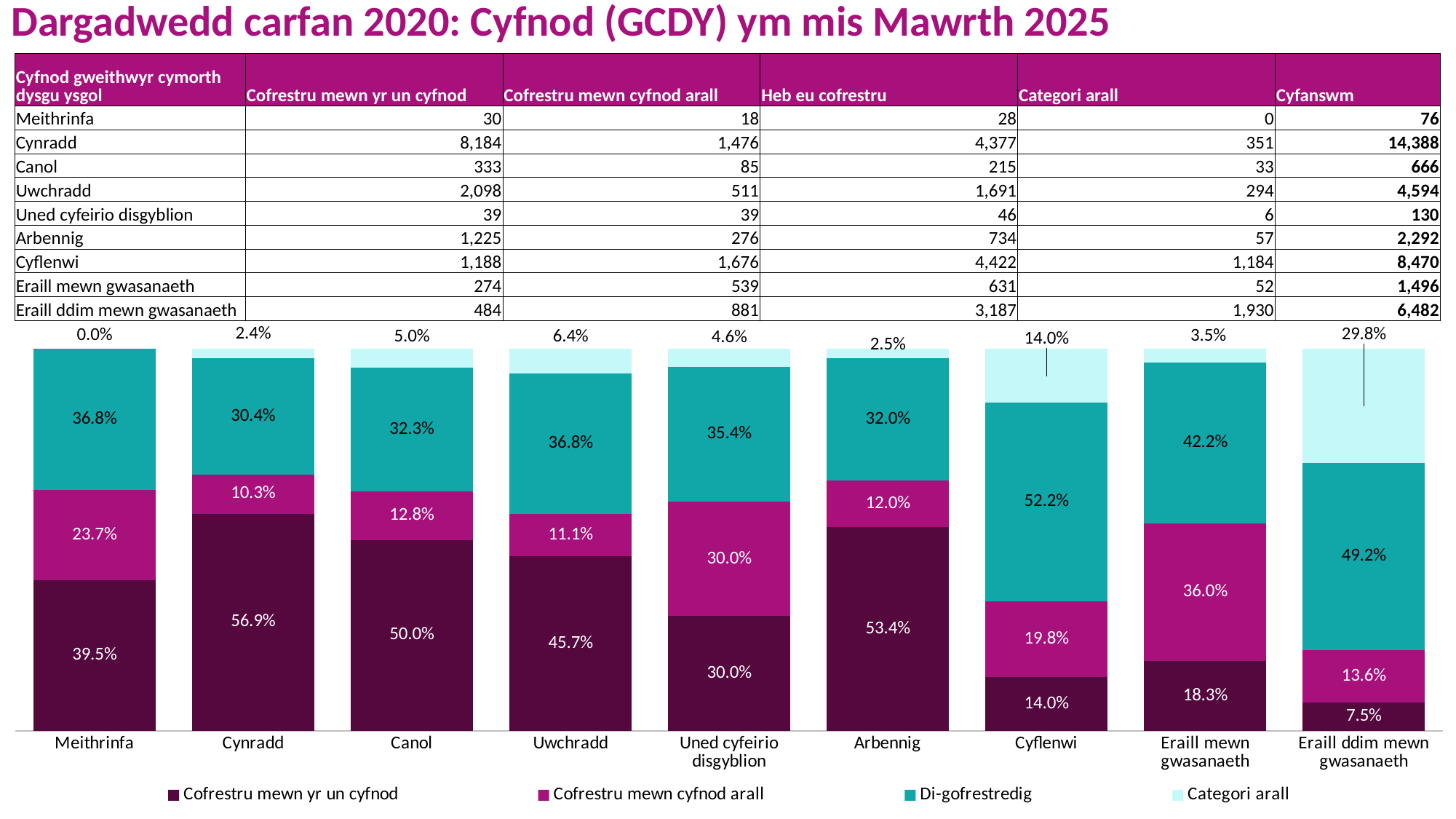
Which category has the highest value for 'Cofrestru mewn yr un cyfnod' in the chart? Cynradd What is the difference between the 'Cofrestru mewn cyfnod arall' values for Eraill mewn gwasanaeth and Cynradd in the chart? 25.7% Which category has the highest value for 'Categori arall' in the chart? Eraill ddim mewn gwasanaeth What is the value of 'Categori arall' for Eraill ddim mewn gwasanaeth in the chart? 29.8% How many series does the chart legend list? 4 What is the value of 'Cofrestru mewn yr un cyfnod' for Cynradd in the chart? 56.9% How many categories are shown along the x axis of the chart? 9 Which is larger in the chart: the 'Di-gofrestredig' value for Uwchradd or for Canol? Uwchradd Which category has the lowest value for 'Cofrestru mewn yr un cyfnod' in the chart? Eraill ddim mewn gwasanaeth Which series in the chart legend is shown in the darkest colour? Cofrestru mewn yr un cyfnod What is the value of 'Di-gofrestredig' for Cyflenwi in the chart? 52.2% What kind of chart is shown on the slide? Stacked bar chart